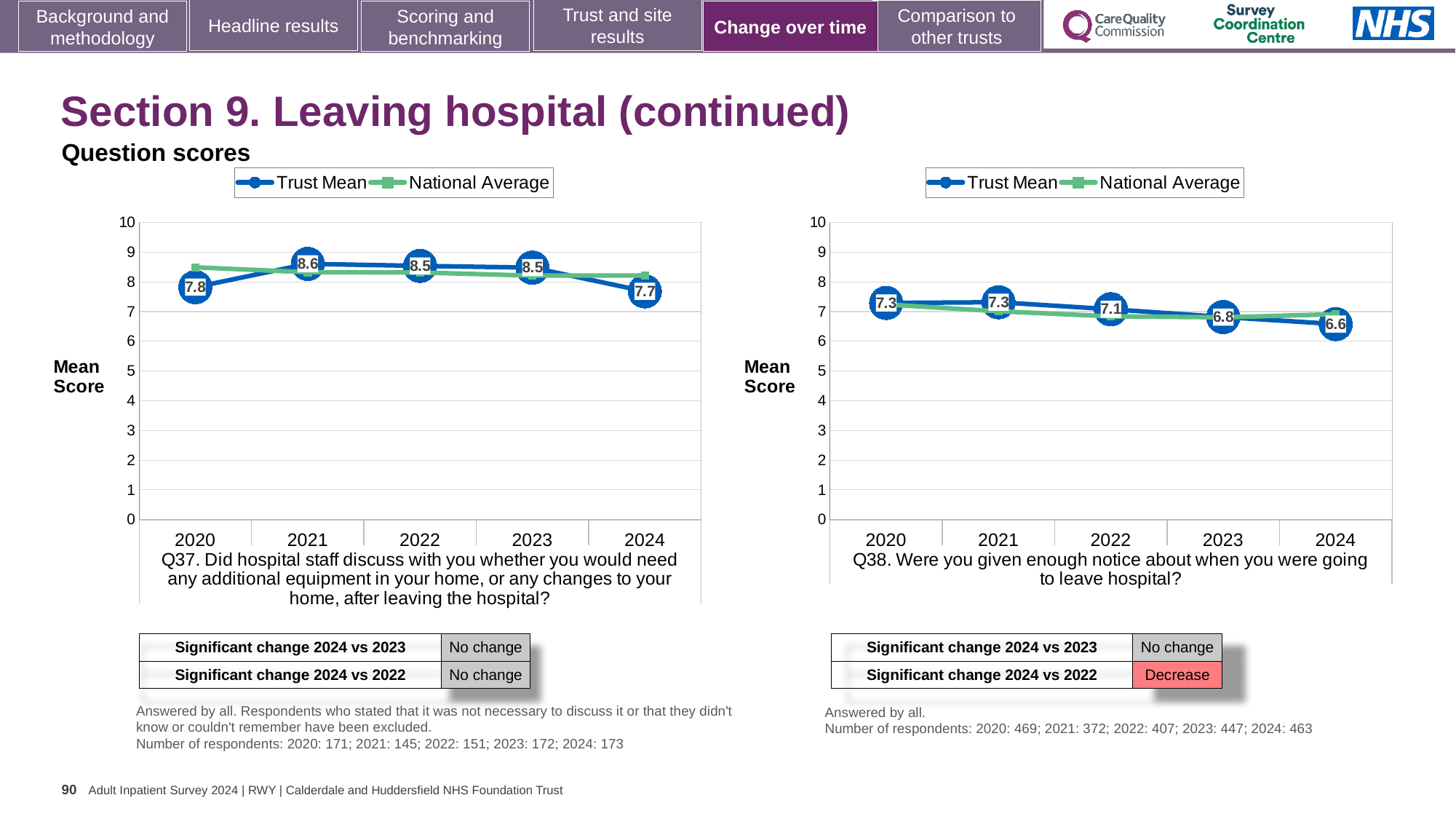
How many years are shown on the x axis of the Q38 chart on the right? 5 In the Q37 chart on the left, is the National Average value for 2020 greater or less than 8? greater In the Q37 chart on the left, which year has the highest Trust Mean score? 2021 In the Q37 chart on the left, what is the Trust Mean score for 2021? 8.6 In the Q38 chart on the right, what is the difference between the Trust Mean scores for 2020 and 2024? 0.7 How many series does the legend of the Q37 chart on the left list? 2 In the Q38 chart on the right, what is the Trust Mean score for 2023? 6.8 What type of chart is the Q38 chart on the right? Line chart In the Q37 chart on the left, what is the difference between the Trust Mean scores for 2021 and 2024? 0.9 In the Q37 chart on the left, is the Trust Mean score higher in 2020 or in 2024? 2020 In the Q38 chart on the right, which year has the lowest Trust Mean score? 2024 In the Q38 chart on the right, does the Trust Mean score rise or fall from 2020 to 2024? Fall